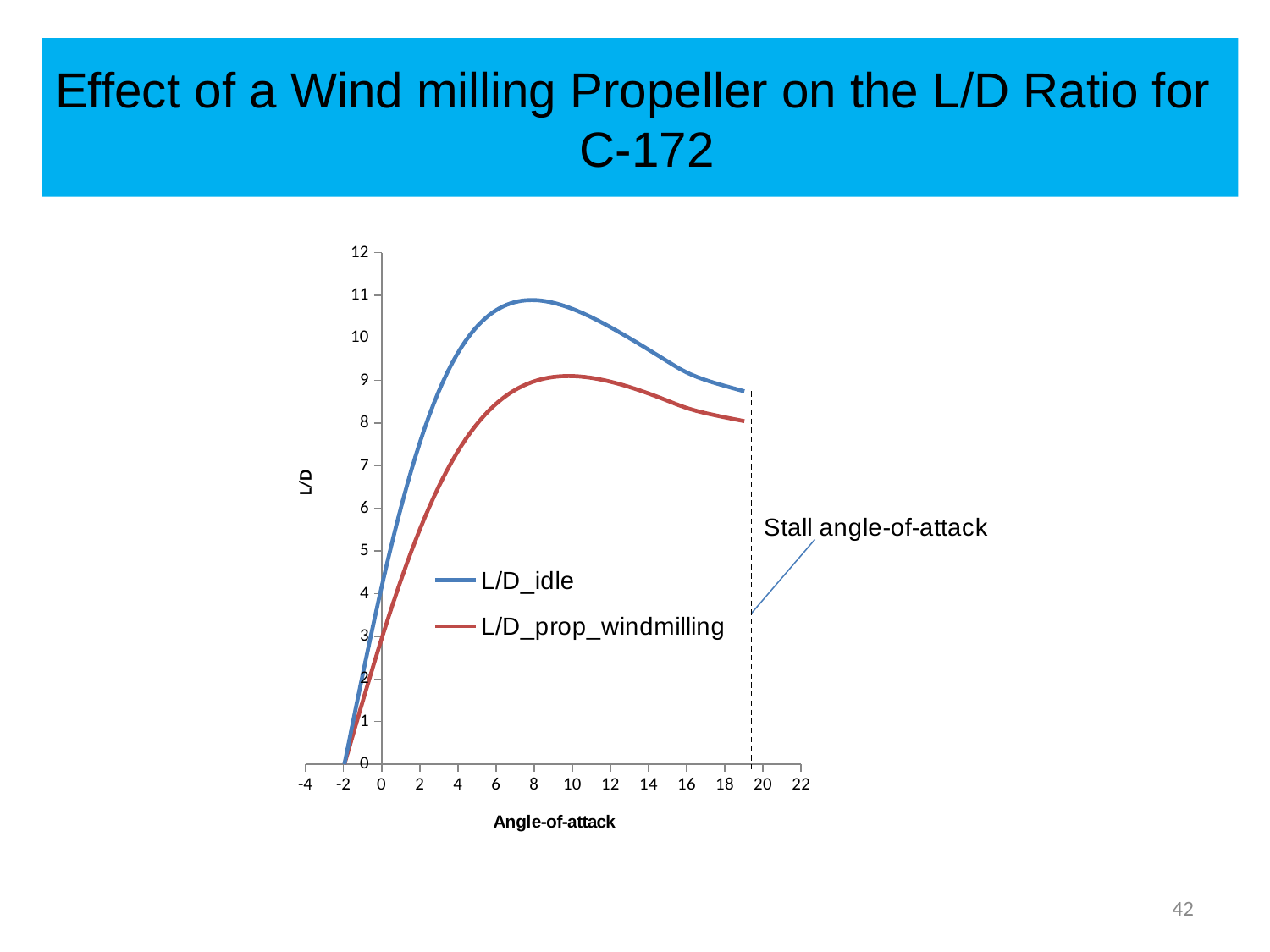
Is the value of L/D_prop_windmilling at an angle-of-attack of 10 greater or less than 8? greater Which series has the higher L/D at an angle-of-attack of 8? L/D_idle Which series reaches the higher peak L/D value? L/D_idle Is the value of L/D_idle at an angle-of-attack of 18 greater or less than 8? greater Is the peak value of L/D_prop_windmilling greater or less than 10? less What are the two series named in the legend? L/D_idle and L/D_prop_windmilling What kind of chart is shown on the slide? Line chart What is the title of the x axis? Angle-of-attack Does L/D_prop_windmilling rise or fall as the angle-of-attack increases from -2 to 6? rise How many series does the legend list? 2 Does L/D_idle rise or fall as the angle-of-attack increases from 8 to 18? fall